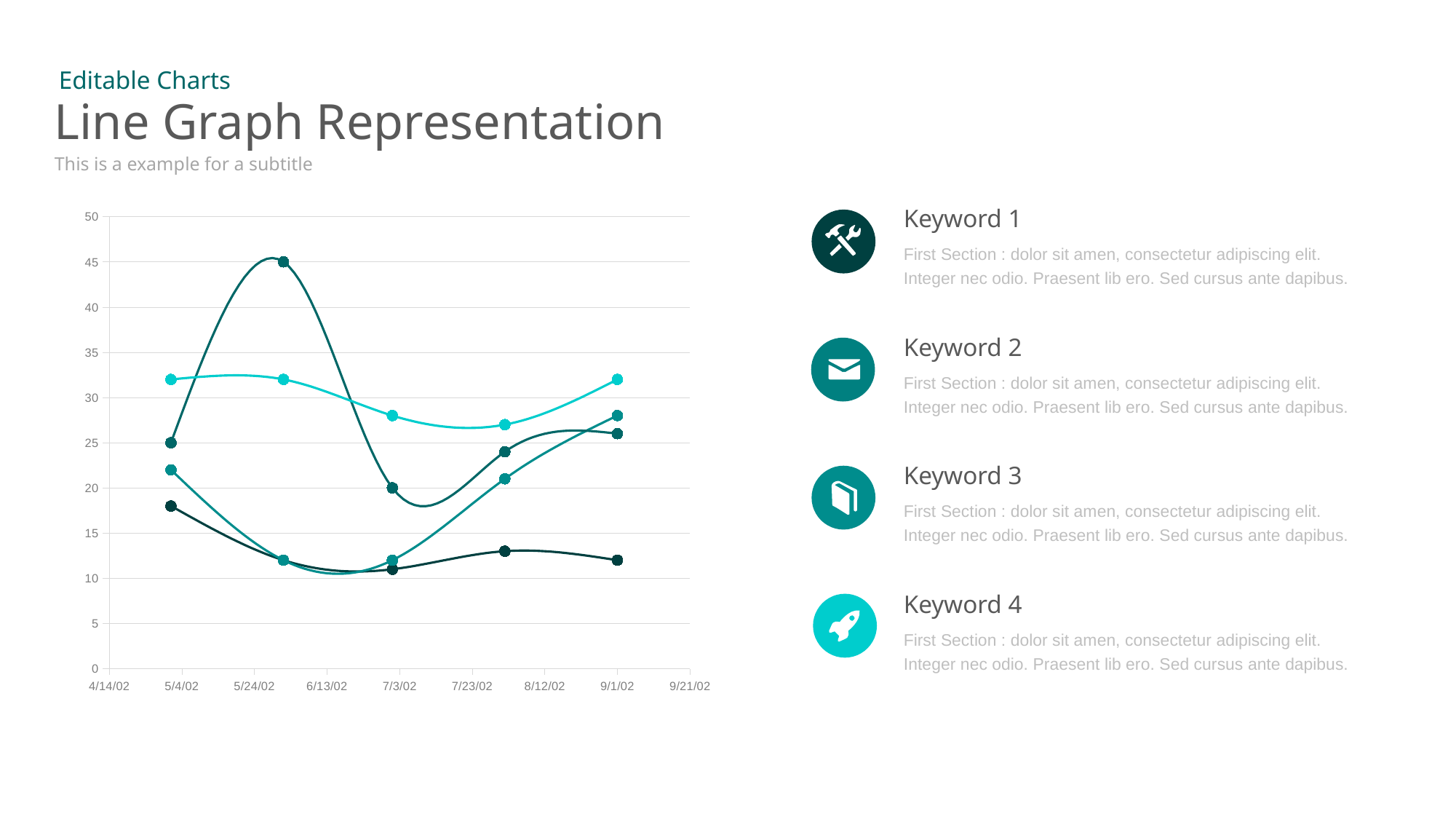
At 9/1/02, which line has the larger value: the lightest (cyan) line or the darkest line? the lightest (cyan) line What is the title of the chart slide? Line Graph Representation What is the highest value reached by any line on the chart? 45 Is the peak value of the dark green line greater or less than 40? greater Between its peak near 5/24/02 and 7/3/02, does the dark green line rise or fall? fall What is the maximum value shown on the vertical axis? 50 How many lines are plotted on the chart? 4 How many date labels are shown on the horizontal axis? 9 Is the value of the darkest line at 9/1/02 greater or less than 15? less What kind of chart is shown on the slide? line chart Which line reaches the highest value on the chart? the dark green line Is the value of the lightest (cyan) line at 9/1/02 greater or less than 30? greater